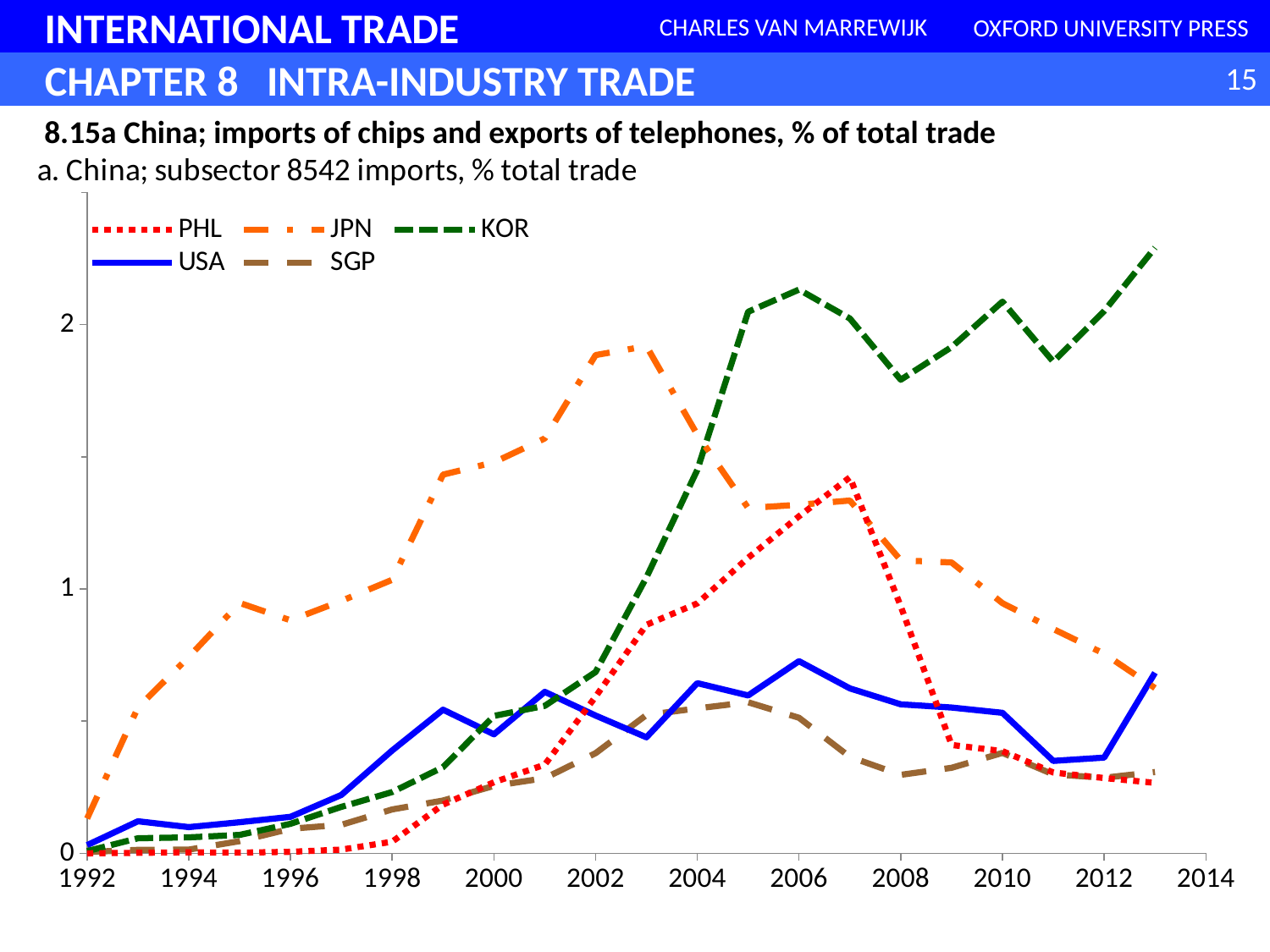
Is the value for KOR in 2006 greater or less than 2? greater Is the value for JPN in 2003 greater or less than 2? less Is the value for PHL in 2007 greater or less than 1? greater What is the title printed directly above the chart? a. China; subsector 8542 imports, % total trade Which series has the highest value in 2013? KOR In 2003, which is larger, the value for JPN or the value for USA? JPN What kind of chart is shown on the slide? line chart How many series does the legend list? 5 Which series are listed in the legend? PHL, JPN, KOR, USA, SGP Does the JPN series rise or fall between 2003 and 2013? fall Which series has the highest value in 2002? JPN